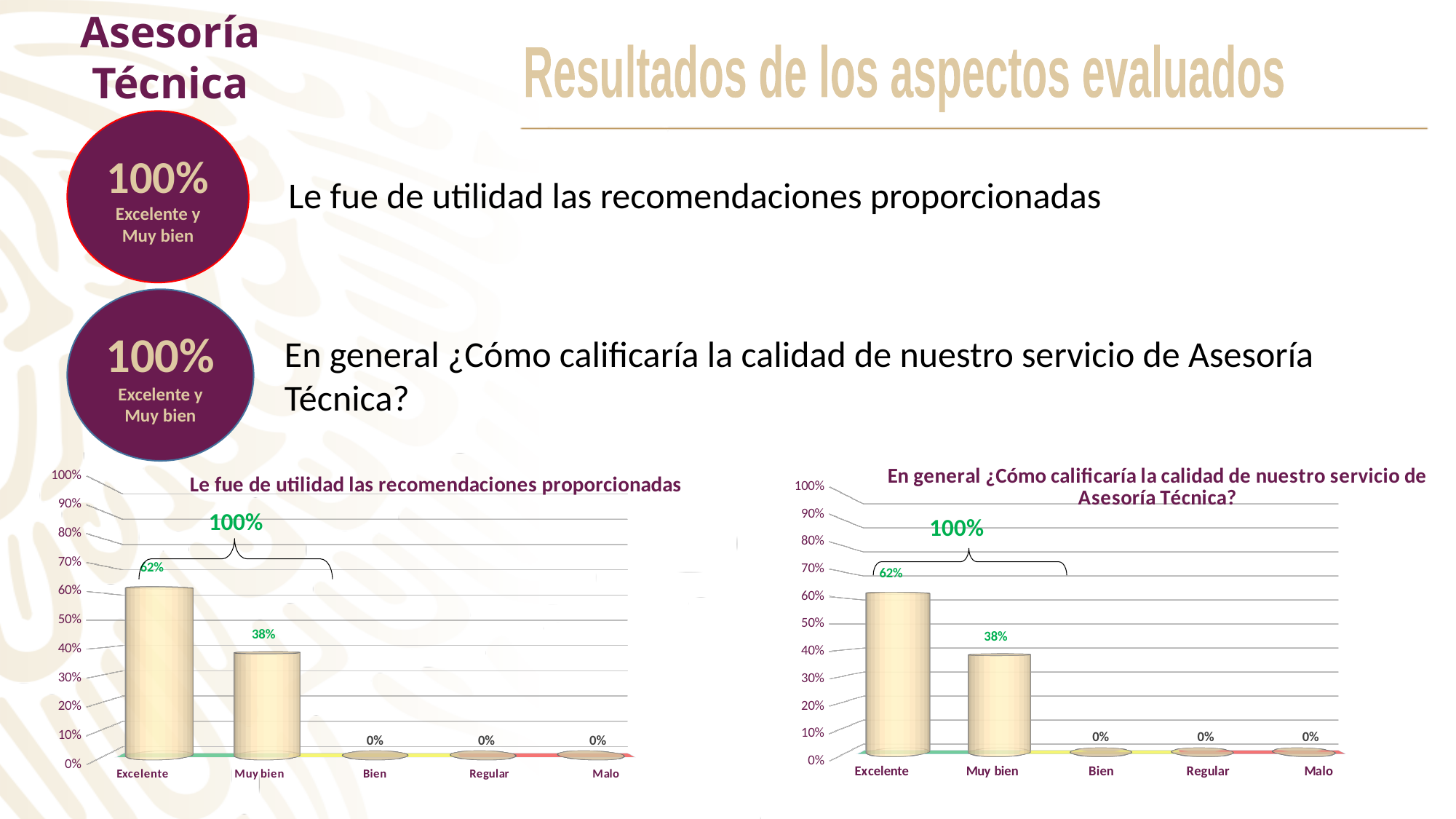
In the right chart titled "En general ¿Cómo calificaría la calidad de nuestro servicio de Asesoría Técnica?", what is the value for Regular? 0% In the left chart titled "Le fue de utilidad las recomendaciones proporcionadas", is the value for Excelente greater or less than 50%? greater How many categories are shown on the x axis of the right chart titled "En general ¿Cómo calificaría la calidad de nuestro servicio de Asesoría Técnica?"? 5 In the left chart titled "Le fue de utilidad las recomendaciones proporcionadas", what is the difference between the values for Excelente and Muy bien? 24% In the left chart titled "Le fue de utilidad las recomendaciones proporcionadas", what is the value for Muy bien? 38% In the left chart titled "Le fue de utilidad las recomendaciones proporcionadas", what is the value for Excelente? 62% In the right chart titled "En general ¿Cómo calificaría la calidad de nuestro servicio de Asesoría Técnica?", which category has the highest value? Excelente What is the title of the chart on the right side of the slide? En general ¿Cómo calificaría la calidad de nuestro servicio de Asesoría Técnica? In the left chart titled "Le fue de utilidad las recomendaciones proporcionadas", what combined percentage is shown by the bracket over Excelente and Muy bien? 100% What kind of chart is the left chart titled "Le fue de utilidad las recomendaciones proporcionadas"? Bar chart In the right chart titled "En general ¿Cómo calificaría la calidad de nuestro servicio de Asesoría Técnica?", which is larger, the value for Muy bien or the value for Bien? Muy bien In the right chart titled "En general ¿Cómo calificaría la calidad de nuestro servicio de Asesoría Técnica?", do the values rise or fall from Excelente to Malo? Fall